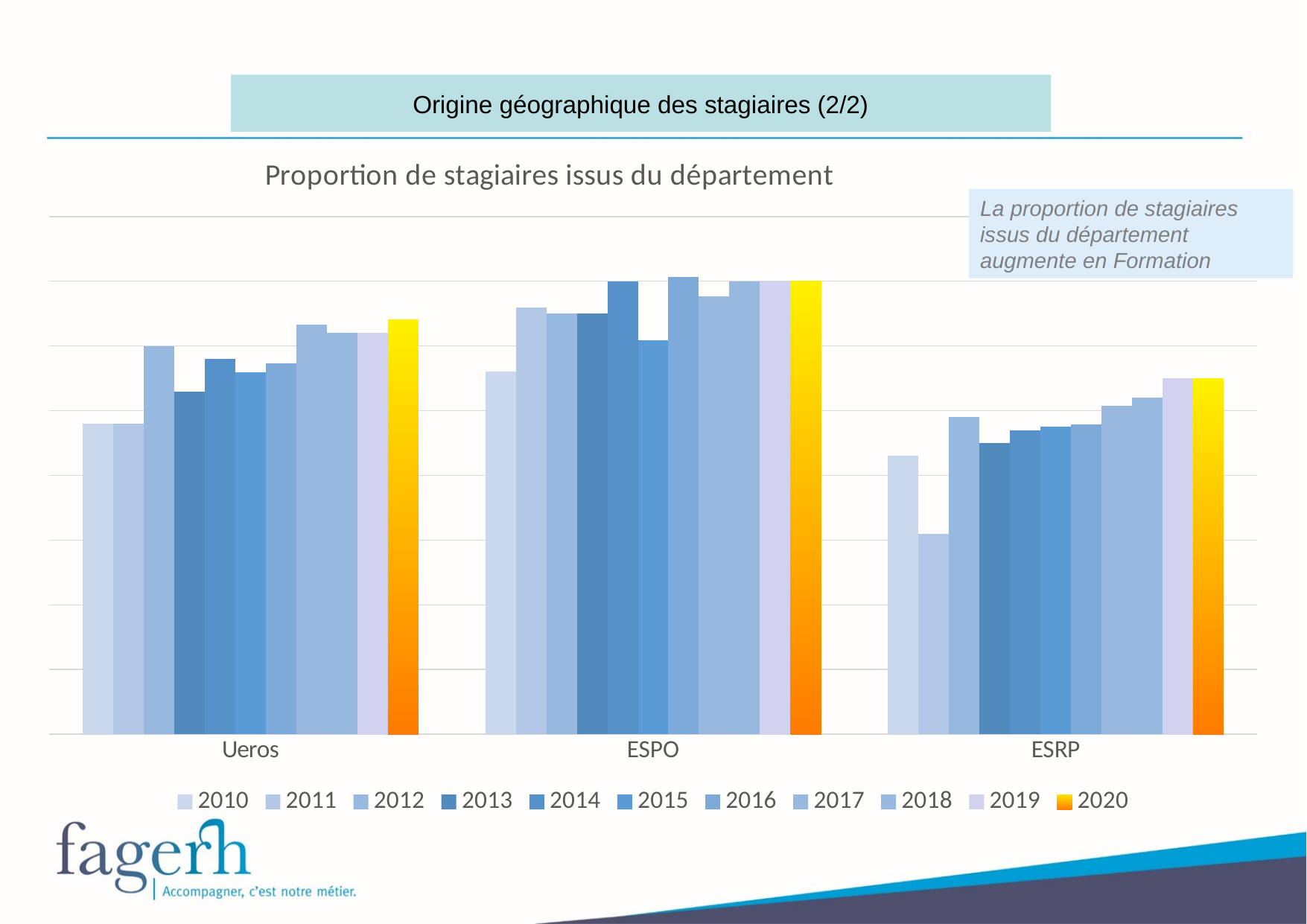
What is the title of the chart? Proportion de stagiaires issus du département Which category has the lowest bar for 2011? ESRP Within the ESPO category, which year has the lowest bar? 2010 Which category has the highest bar for 2020? ESPO Within the ESRP category, which year has the lowest bar? 2011 In the ESRP category, which is larger, the bar for 2011 or the bar for 2020? 2020 How many series does the legend list? 11 In the Ueros category, which is larger, the bar for 2010 or the bar for 2012? 2012 Which is larger, the 2020 bar for ESPO or the 2020 bar for ESRP? ESPO How many categories are shown on the x axis of the chart? 3 Which legend entry is shown in yellow/orange rather than blue? 2020 What kind of chart is shown on the slide? Bar chart